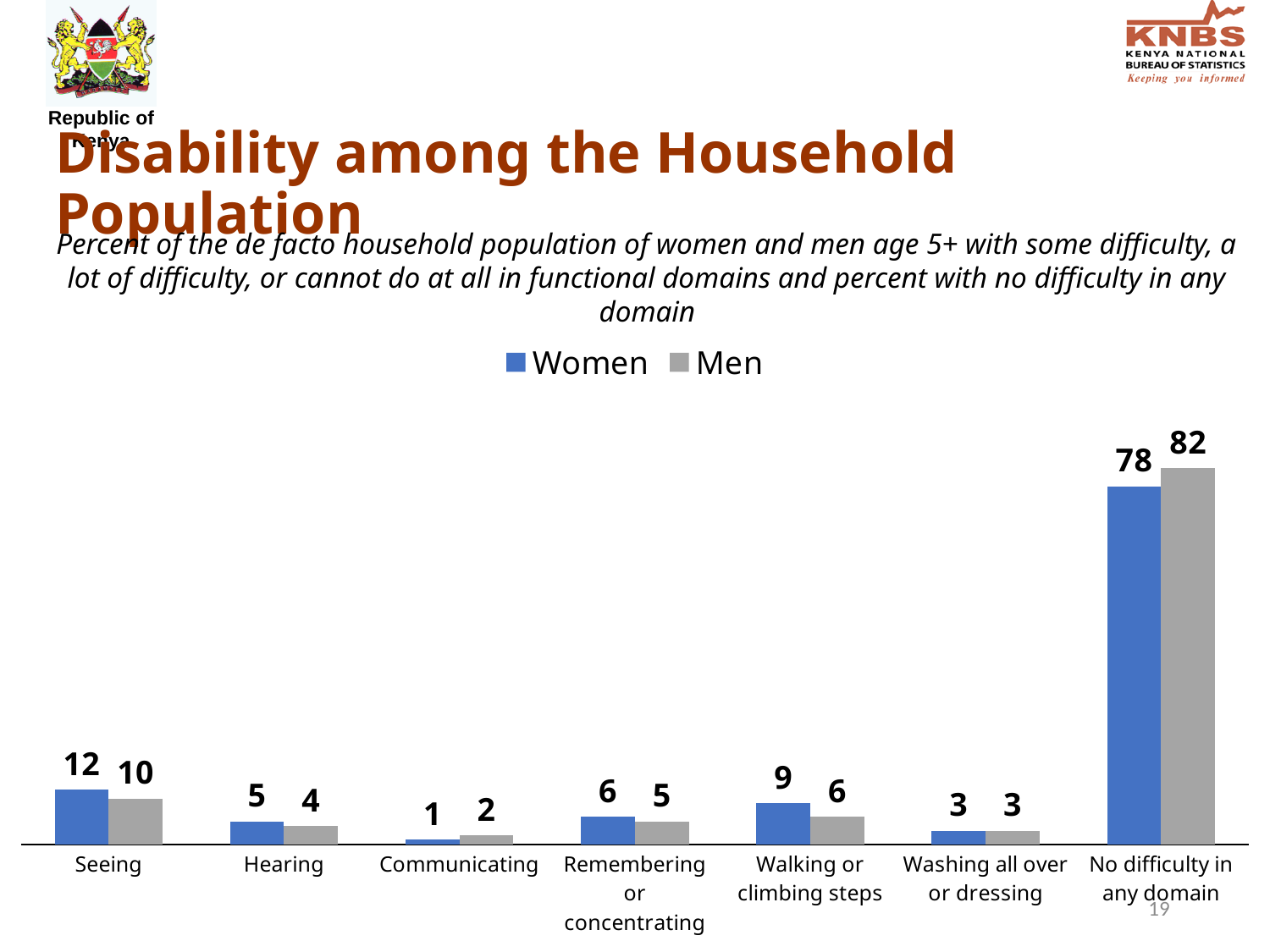
Which category has the highest value for Women? No difficulty in any domain What is the difference between the Men and Women values for No difficulty in any domain? 4 Which is larger in the Hearing category, the value for Women or for Men? Women What is the value for Men in the No difficulty in any domain category? 82 How many categories are shown on the x axis? 7 What is the value for Women in the Seeing category? 12 Which category has the lowest value for Women? Communicating Which is larger in the Communicating category, the value for Women or for Men? Men What kind of chart is shown on the slide? Bar chart What is the value for Men in the Walking or climbing steps category? 6 How many series does the legend list? 2 What colour represents the Men series in the chart? Grey